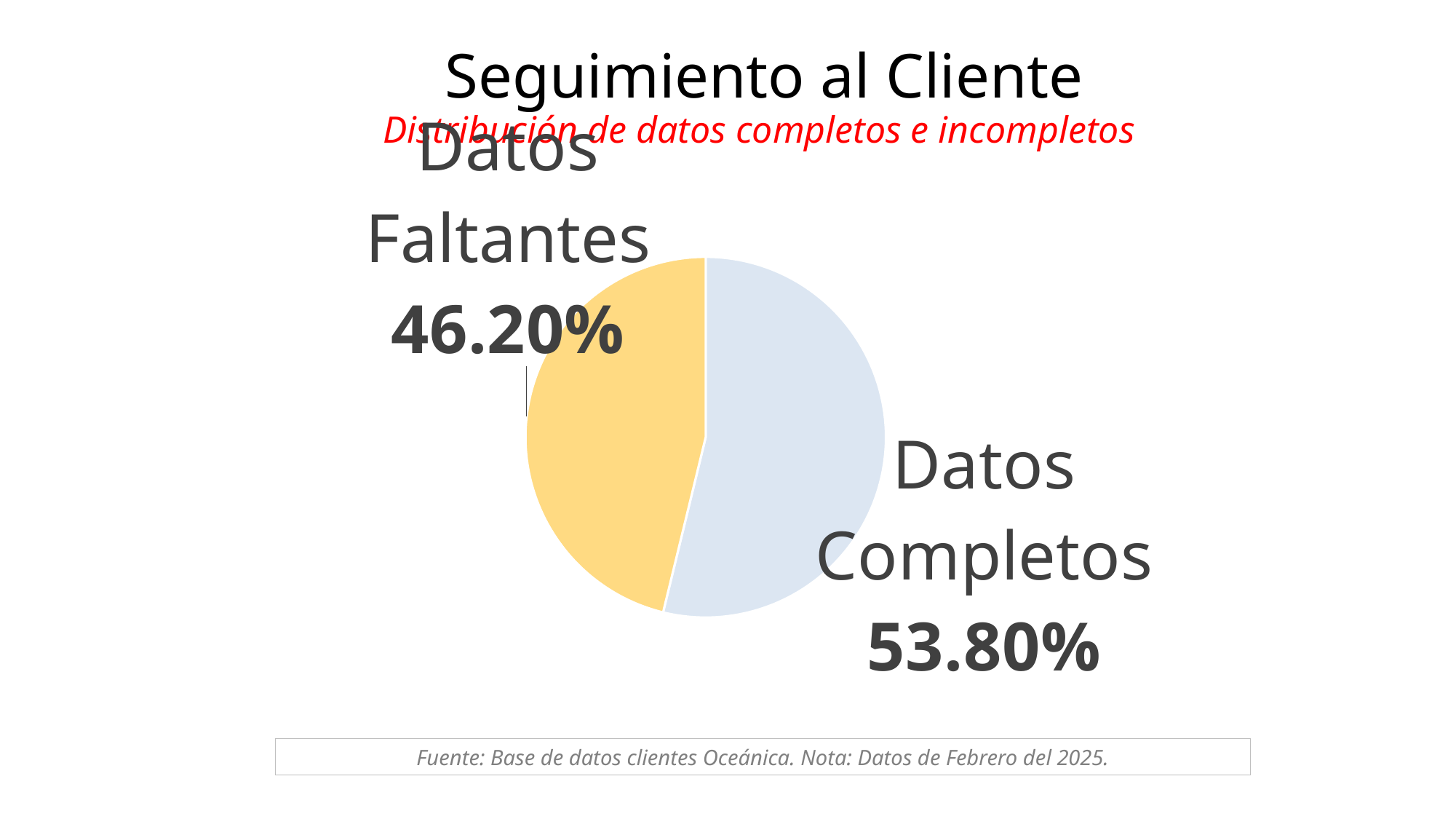
Which slice of the pie is the smallest? Datos Faltantes What percentage is shown for Datos Completos? 53.80% What colour is the Datos Faltantes slice? yellow What kind of chart is shown on the slide? pie chart What is the difference in percentage points between Datos Completos and Datos Faltantes? 7.60% Which is larger, Datos Completos or Datos Faltantes? Datos Completos What is the subtitle of the chart shown in red? Distribución de datos completos e incompletos Which slice of the pie is the largest? Datos Completos How many slices does the pie chart have? 2 What percentage is shown for Datos Faltantes? 46.20%